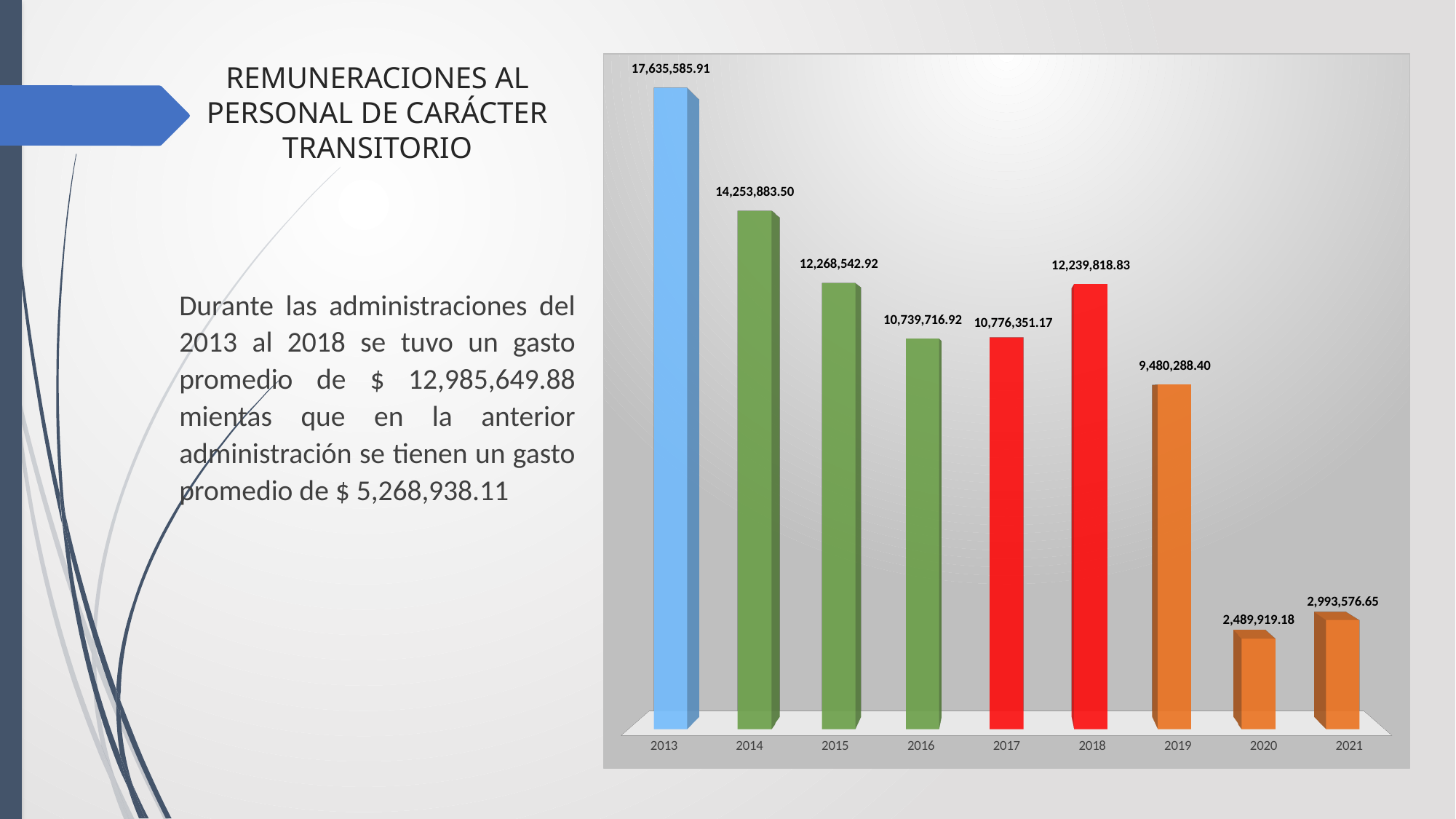
What is the value for 2013? 17,635,585.91 What is the difference between the values for 2021 and 2020? 503,657.47 What is the value for 2020? 2,489,919.18 Which is larger, the value for 2014 or the value for 2019? 2014 What kind of chart is shown on the slide? Bar chart What is the difference between the values for 2013 and 2014? 3,381,702.41 What is the value for 2017? 10,776,351.17 Which year has the lowest value? 2020 What is the value for 2019? 9,480,288.40 Do the values generally rise or fall from 2013 to 2021? Fall Which year has the highest value? 2013 How many years are shown on the chart? 9